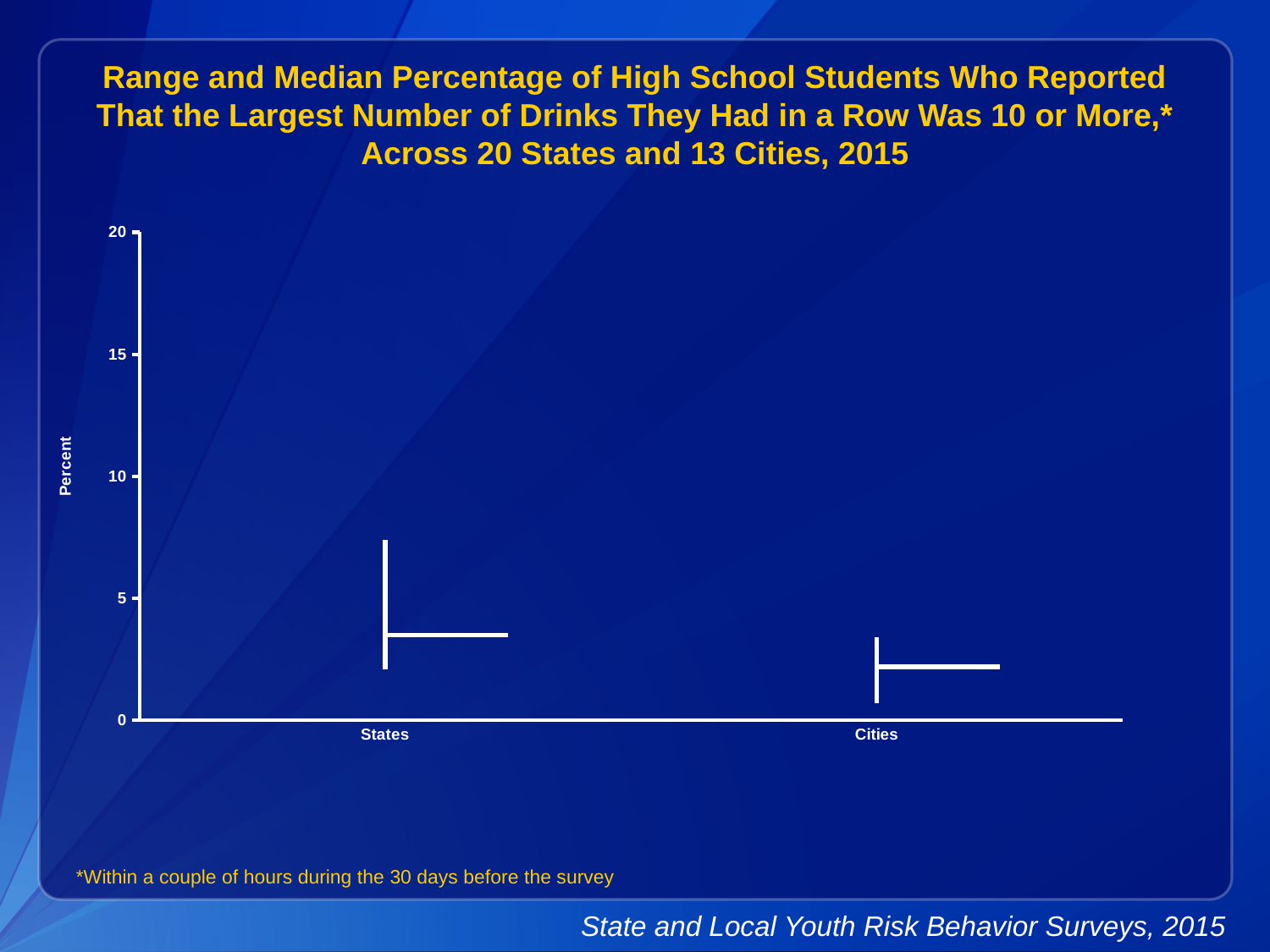
Is the median value for States greater or less than 5? less What is the label of the y axis? Percent What is the highest value shown on the y axis? 20 Is the upper end of the range for States greater or less than 5? greater How many categories are shown on the x axis of the chart? 2 Which category has the higher median value, States or Cities? States Is the median value for Cities greater or less than 5? less Which category has the lower bottom end of its range, States or Cities? Cities Which category has the higher upper end of its range, States or Cities? States What are the two categories shown on the x axis? States and Cities